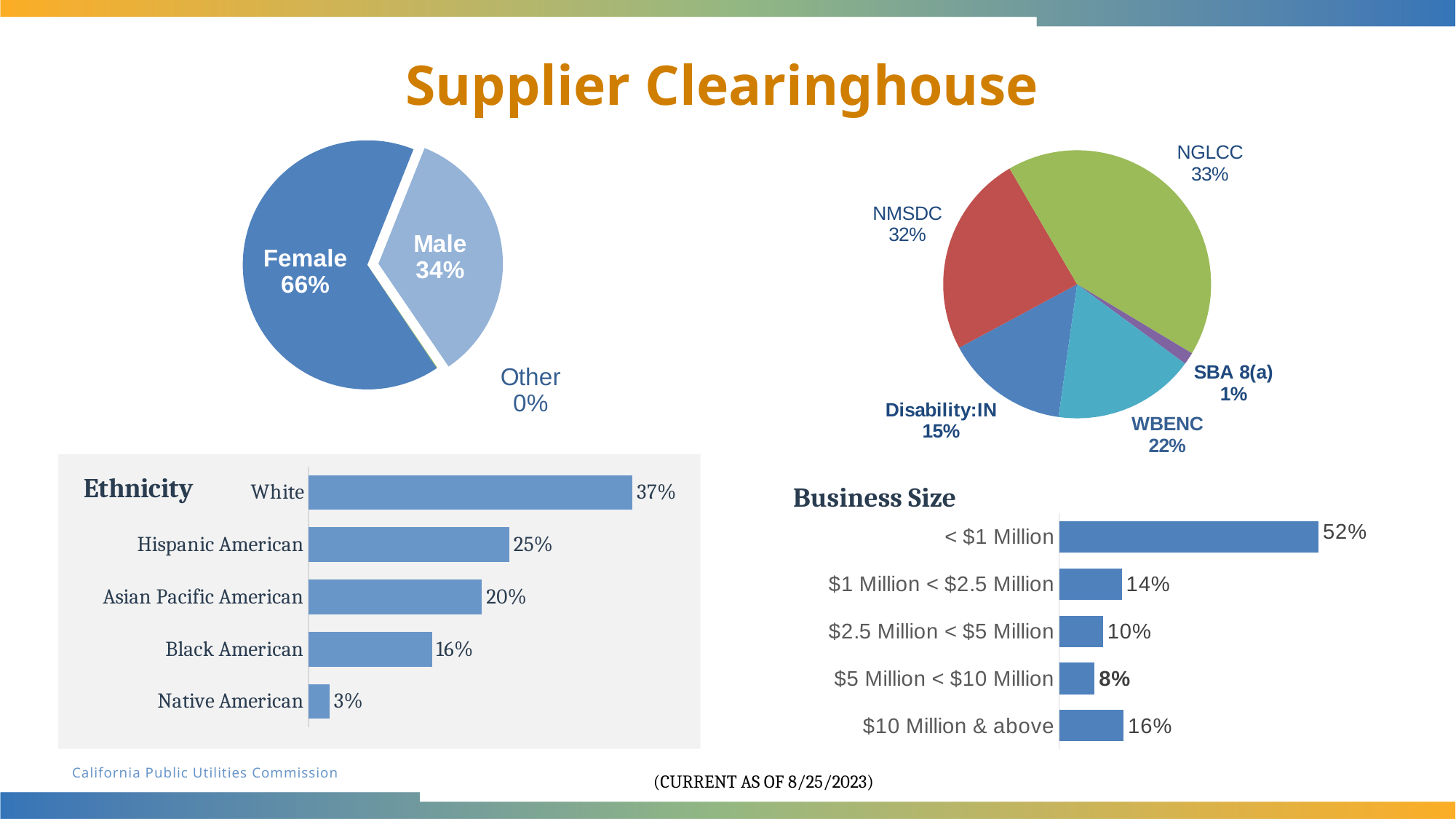
In the certification pie chart at the top right, which category has the smallest share? SBA 8(a) In the Ethnicity chart, what is the value for Hispanic American? 25% What kind of chart is the Business Size chart? Bar chart In the certification pie chart at the top right, how many categories are shown? 5 In the certification pie chart at the top right, which category has the largest share? NGLCC In the Ethnicity chart, which category has the lowest value? Native American In the Ethnicity chart, what is the difference between White and Black American? 21% In the gender pie chart at the top left, what share is Female? 66% In the gender pie chart at the top left, what share is Male? 34% In the certification pie chart at the top right, what share is NMSDC? 32% In the Business Size chart, what is the value for $2.5 Million < $5 Million? 10% In the Business Size chart, which is larger: $1 Million < $2.5 Million or $10 Million & above? $10 Million & above